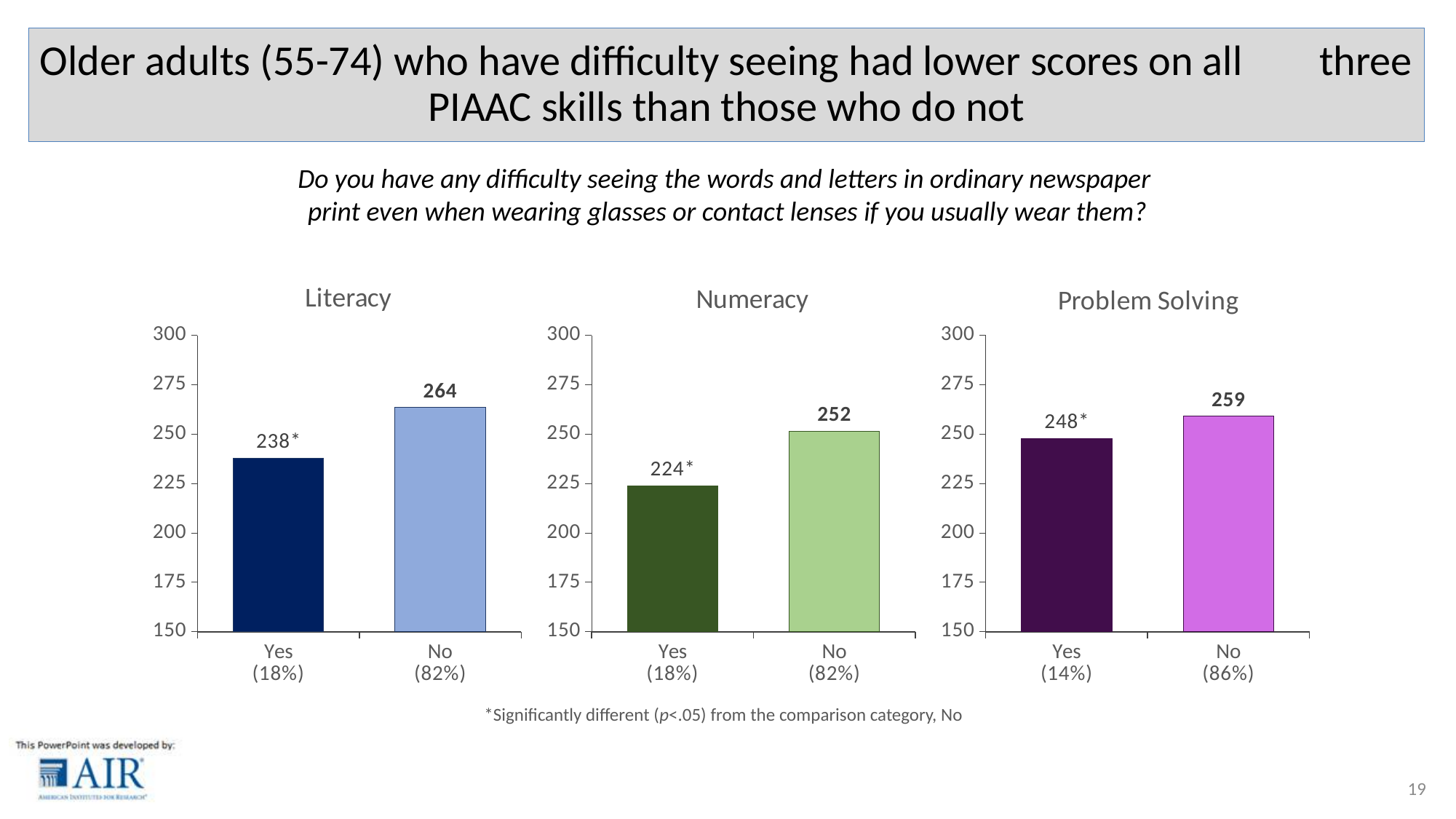
What is the title of the rightmost chart on the slide? Problem Solving In the Numeracy chart, which category has the lowest value? Yes (18%) What kind of chart is the Literacy chart? bar chart In the Numeracy chart, what is the difference between the No and Yes values? 28 In the Literacy chart, what is the value for No (82%)? 264 In the Problem Solving chart, what is the difference between the No and Yes values? 11 In the Problem Solving chart, what is the value for No (86%)? 259 In the Problem Solving chart, is the value for Yes greater or less than 250? less In the Numeracy chart, what is the value for Yes (18%)? 224 In the Literacy chart, which category has the higher value, Yes or No? No How many categories are shown in the Numeracy chart? 2 In the Literacy chart, what is the value for Yes (18%)? 238